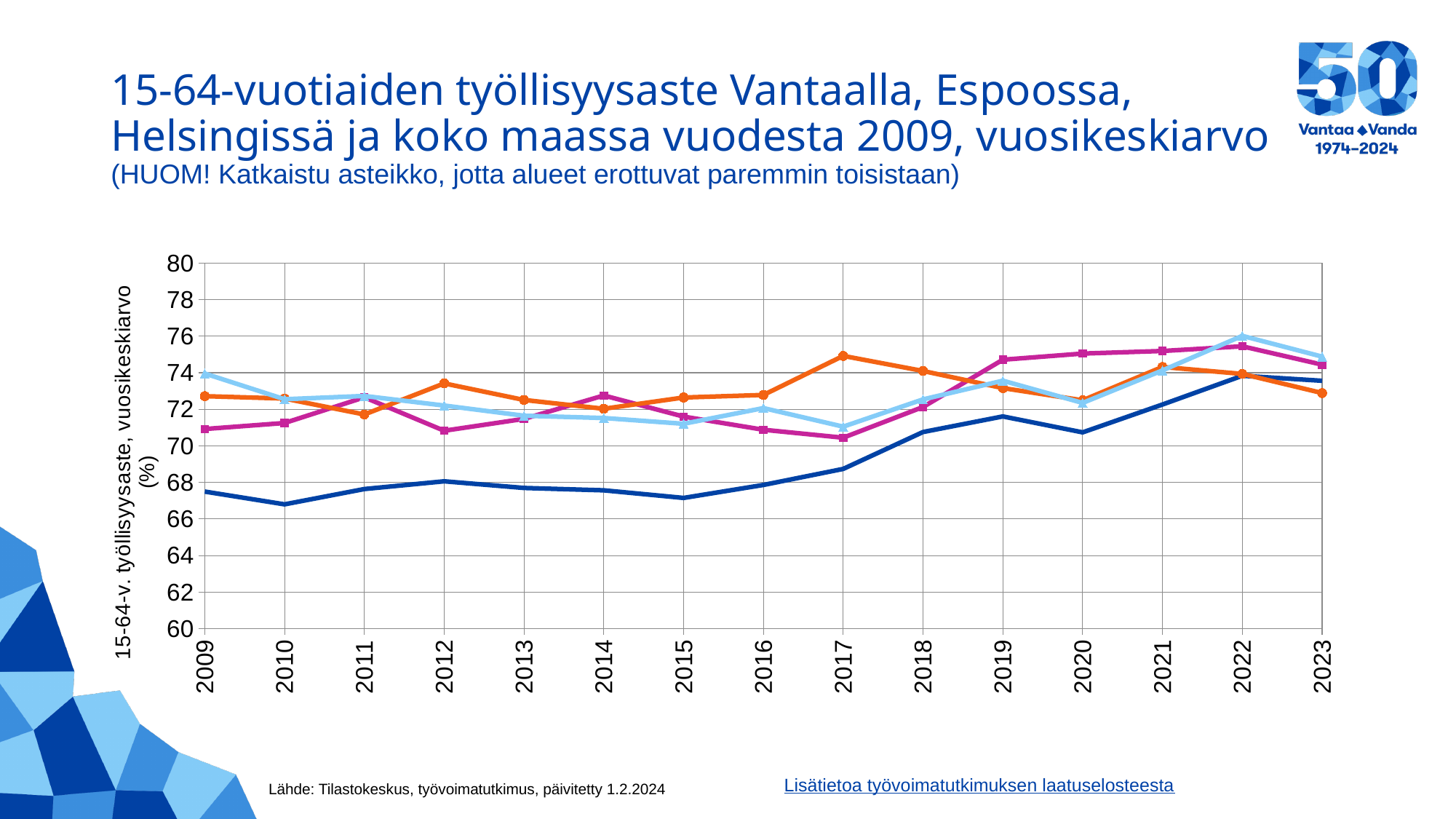
Does the dark blue line overall rise or fall from 2009 to 2023? rise In which year does the dark blue line reach its lowest value? 2010 Is the value of the light blue line in 2022 greater or less than 74? greater How many lines are plotted on the chart? 4 In 2009, which line has the higher value, the dark blue line or the orange line? the orange line What kind of chart is shown on the slide? line chart Is the value of the orange line in 2017 greater or less than 74? greater How many years are shown on the x axis of the chart? 15 Is the value of the dark blue line in 2022 greater or less than 72? greater In 2023, which line has the higher value, the magenta line or the orange line? the magenta line